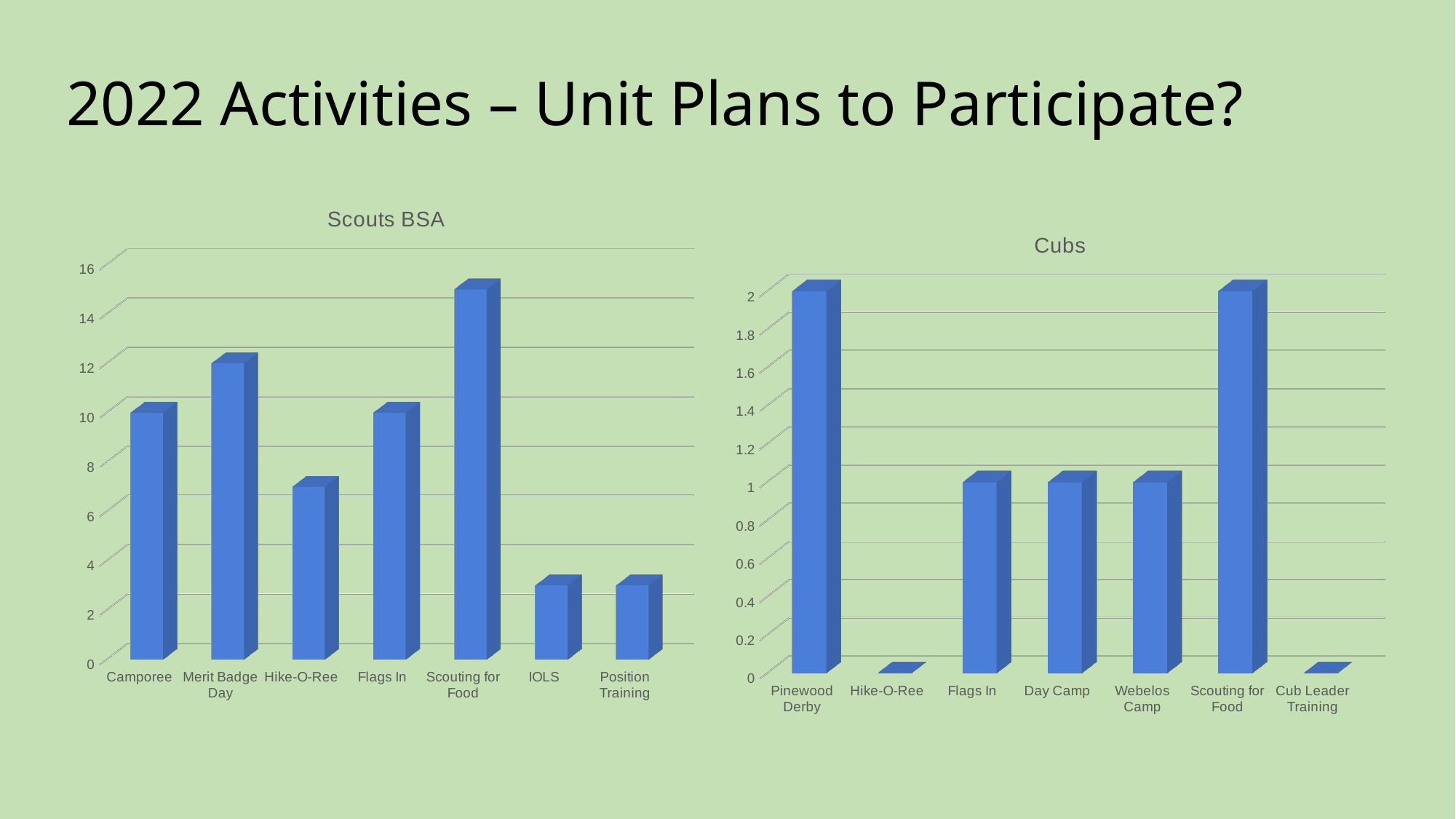
In the Scouts BSA chart, what is the difference between Merit Badge Day and Camporee? 2 In the Scouts BSA chart, is the value for Scouting for Food greater or less than 14? greater What type of chart is the Scouts BSA chart? bar chart In the Scouts BSA chart, which is larger, Merit Badge Day or Camporee? Merit Badge Day How many categories are shown in the Cubs chart? 7 In the Scouts BSA chart, which category has the highest value? Scouting for Food In the Scouts BSA chart, is the value for Hike-O-Ree greater or less than 8? less In the Cubs chart, what is the value for Day Camp? 1 In the Cubs chart, what is the difference between Scouting for Food and Webelos Camp? 1 In the Scouts BSA chart, what is the value for Merit Badge Day? 12 In the Scouts BSA chart, what is the value for Camporee? 10 In the Cubs chart, what is the value for Pinewood Derby? 2